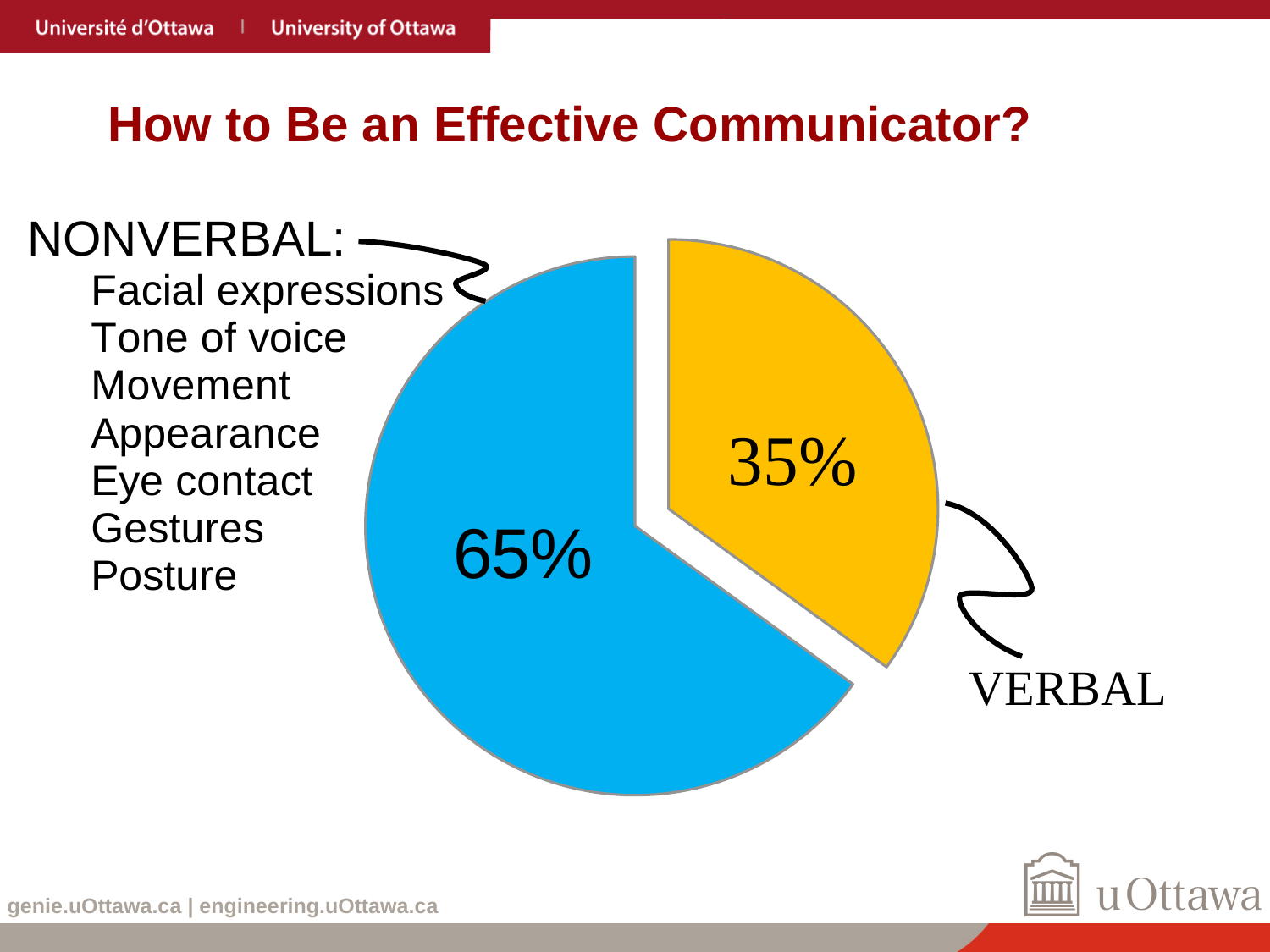
What colour is the NONVERBAL slice? blue Which is larger, the NONVERBAL slice or the VERBAL slice? NONVERBAL What colour is the VERBAL slice? yellow Which slice of the pie is the largest? NONVERBAL Which slice of the pie is the smallest? VERBAL What kind of chart is shown on the slide? pie chart What percentage does the VERBAL slice show? 35% What percentage does the NONVERBAL slice show? 65% What is the difference in percentage points between the NONVERBAL and VERBAL slices? 30 How many slices does the pie chart have? 2 What share of the pie does the VERBAL slice represent? 35%